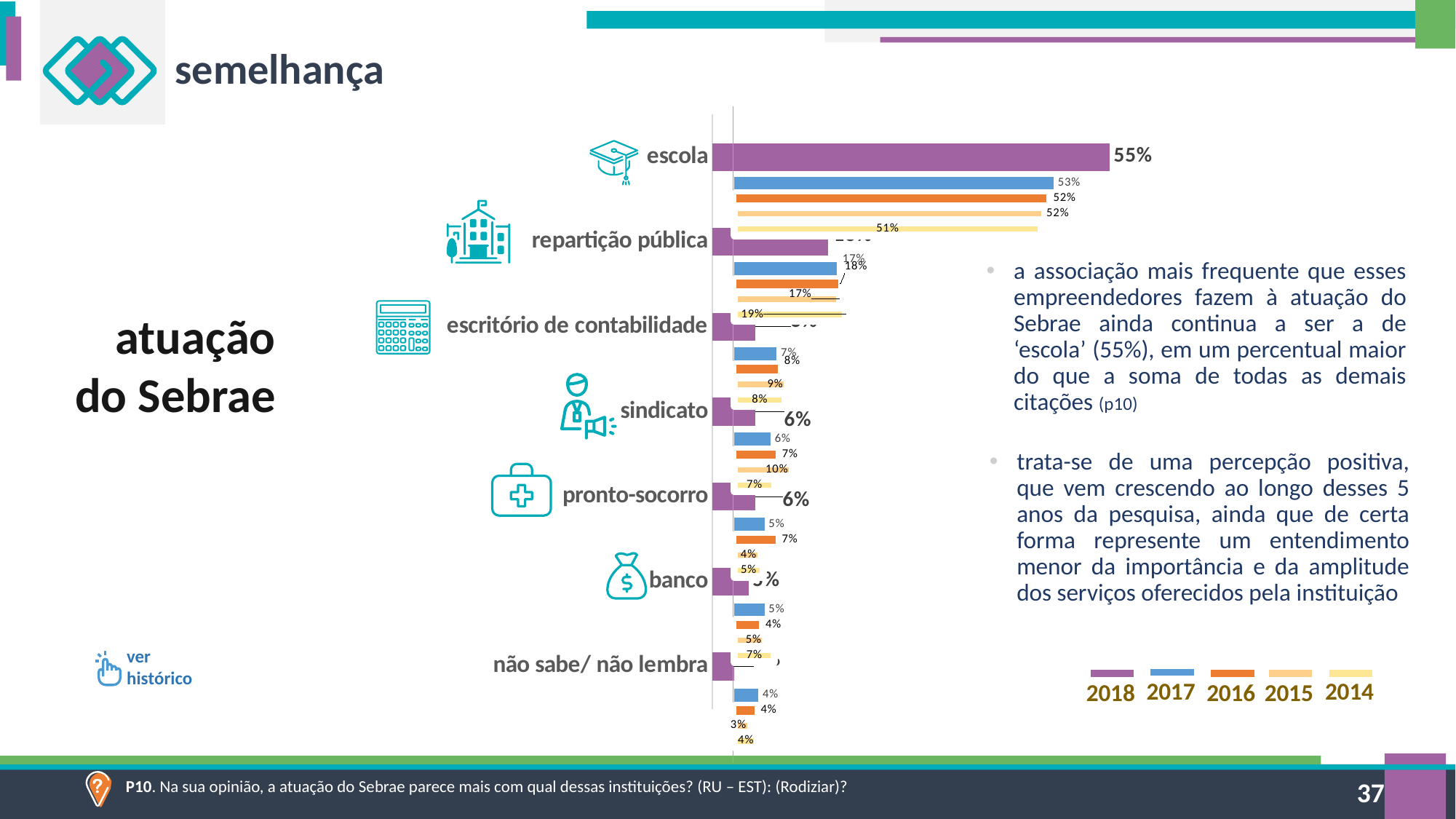
What kind of chart is shown on the slide? bar chart What is the difference between the 'escola' value in 2018 and in 2014? 4 percentage points What is the value for 'escola' in 2017? 53% What is the value for 'escola' in 2018? 55% How many series does the legend list? 5 How many categories are shown in the chart? 7 Which years are listed in the legend? 2018, 2017, 2016, 2015, 2014 What is the value for 'sindicato' in 2015? 10% What is the value for 'banco' in 2014? 7% What is the value for 'escola' in 2014? 51% For 'sindicato', which year has the larger value, 2015 or 2016? 2015 Which category has the highest value in 2018? escola